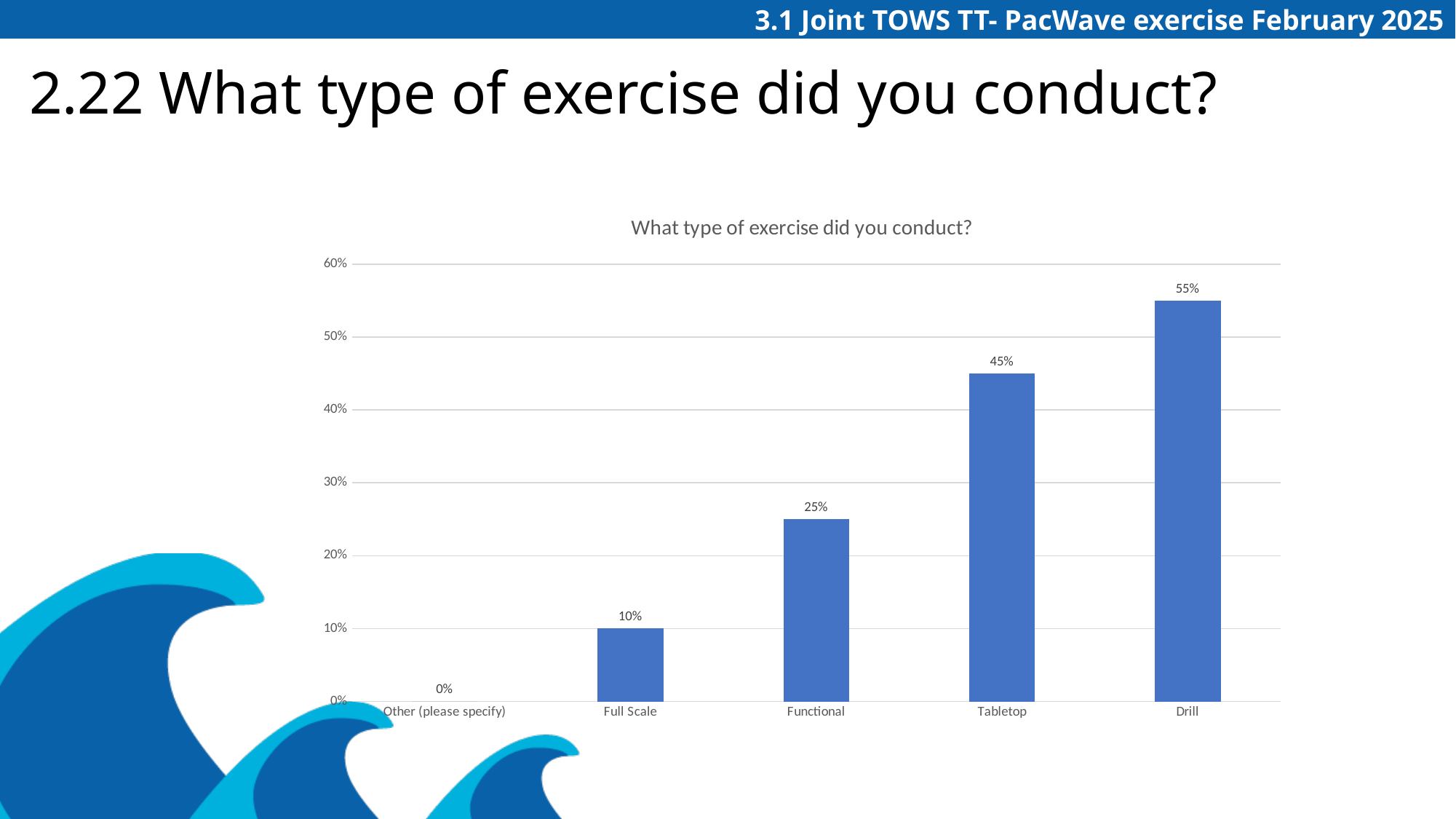
What kind of chart is shown on the slide? Bar chart Which is larger, the value for Functional or the value for Full Scale? Functional Which category has the lowest value? Other (please specify) What is the value for Full Scale? 10% What is the difference between the values for Drill and Tabletop? 10% Which category has the highest value? Drill What is the value for Tabletop? 45% What is the value for Functional? 25% What is the value for Drill? 55% How many categories are shown on the x axis? 5 What is the title of the chart? What type of exercise did you conduct? What is the value for Other (please specify)? 0%